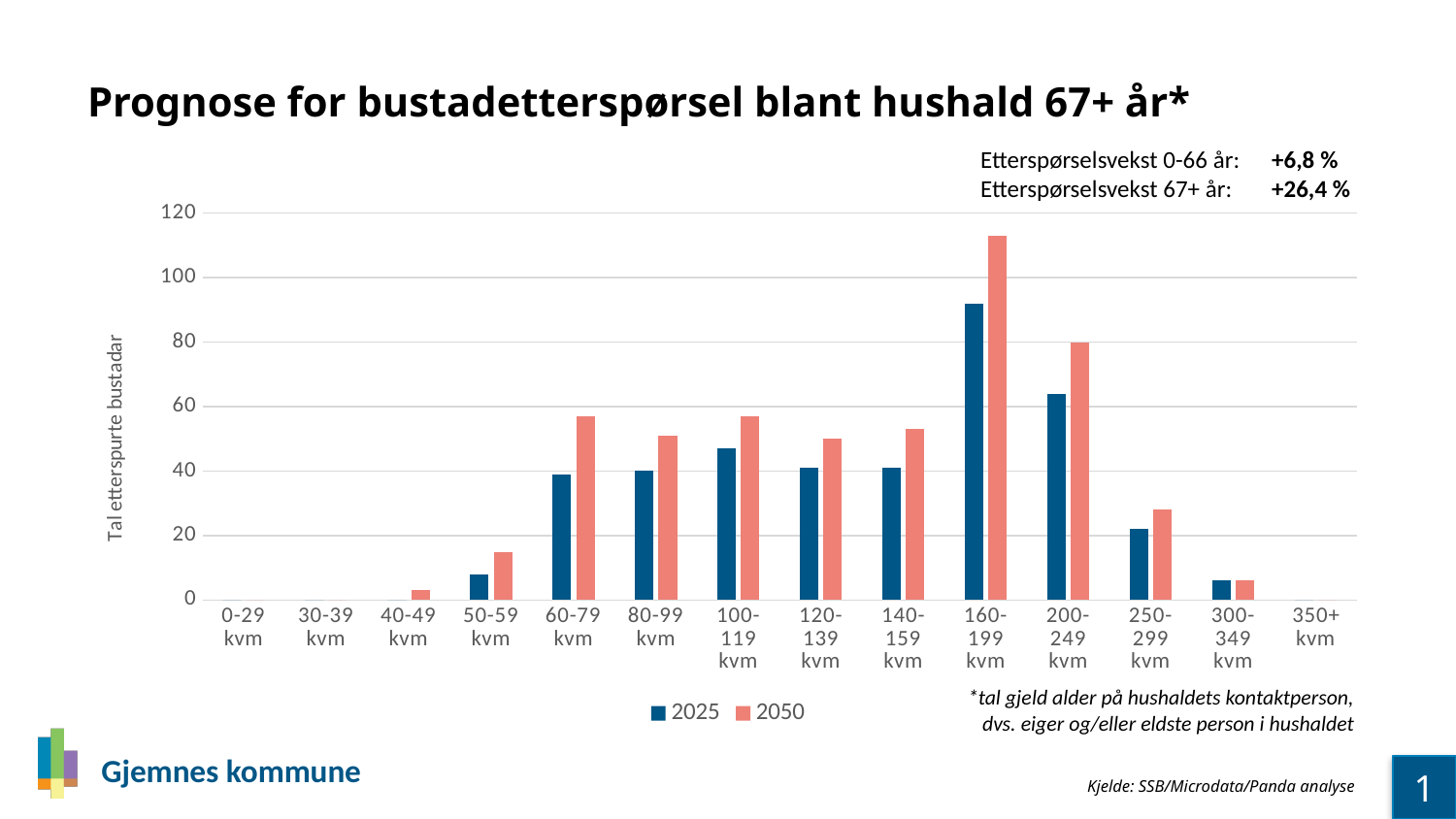
How many series does the legend list? 2 Which size category has the highest value for the 2050 series? 160-199 kvm Is the 2025 value for 200-249 kvm greater or less than 60? greater What kind of chart is shown on the slide? bar chart Which size category has the highest value for the 2025 series? 160-199 kvm Is the 2050 value for 250-299 kvm greater or less than 40? less Is the 2050 value for 160-199 kvm greater or less than 100? greater Which is larger: the 2050 value for 200-249 kvm or the 2050 value for 100-119 kvm? 200-249 kvm What is the title of the chart? Prognose for bustadetterspørsel blant hushald 67+ år* How many size categories are shown on the x axis? 14 For 60-79 kvm, which series has the larger value, 2025 or 2050? 2050